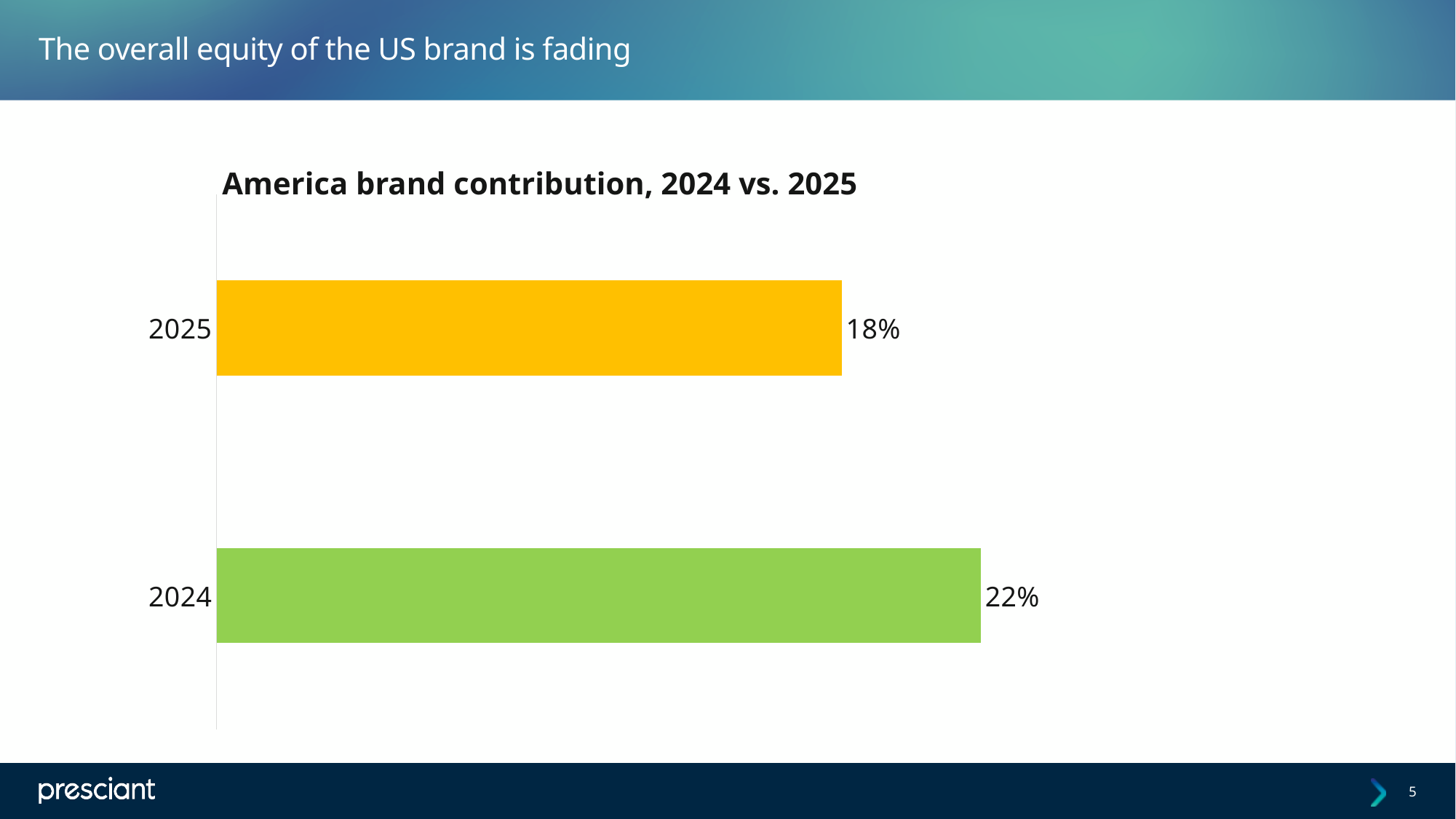
What is the difference between the 2024 and 2025 America brand contribution values? 4% What is the America brand contribution value for 2024? 22% Is the America brand contribution larger in 2024 or in 2025? 2024 What kind of chart is shown on the slide? Bar chart How many categories are shown in the chart? 2 What is the title of the chart? America brand contribution, 2024 vs. 2025 Did the America brand contribution rise or fall from 2024 to 2025? Fall What colour is the bar for 2025? Yellow Which year has the higher America brand contribution? 2024 Which year has the lower America brand contribution? 2025 What is the America brand contribution value for 2025? 18%